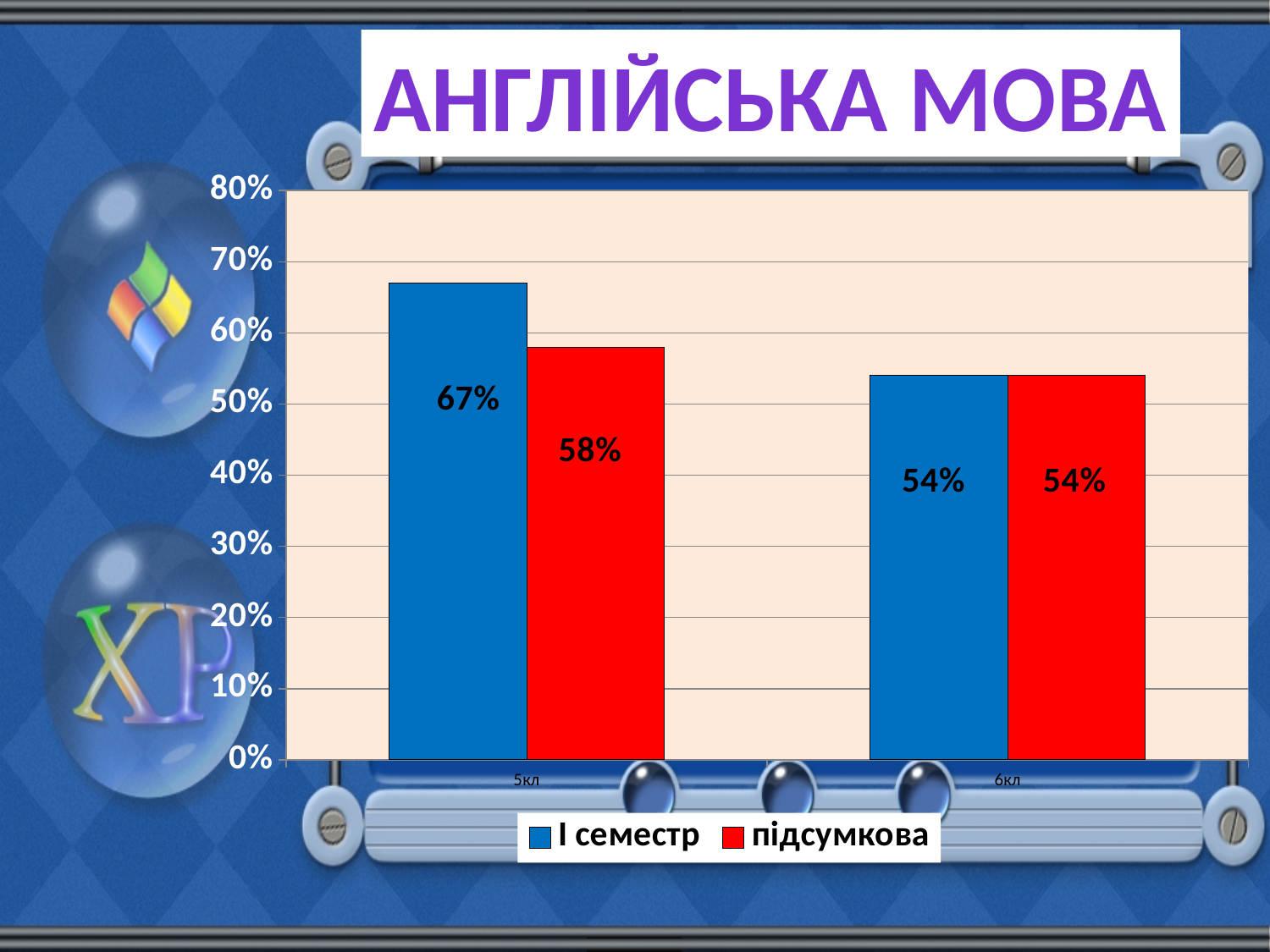
What is the value for підсумкова in the 6кл category? 54% What kind of chart is shown on the slide? bar chart Which category has the highest value for І семестр? 5кл How many series does the legend list? 2 How many categories are shown on the x axis? 2 What is the difference between І семестр and підсумкова in the 5кл category? 9% What is the value for І семестр in the 5кл category? 67% Which category has the lowest value for підсумкова? 6кл What is the value for І семестр in the 6кл category? 54% Is the value for І семестр in the 5кл category greater or less than 60%? greater Which is larger in the 5кл category: І семестр or підсумкова? І семестр What is the value for підсумкова in the 5кл category? 58%